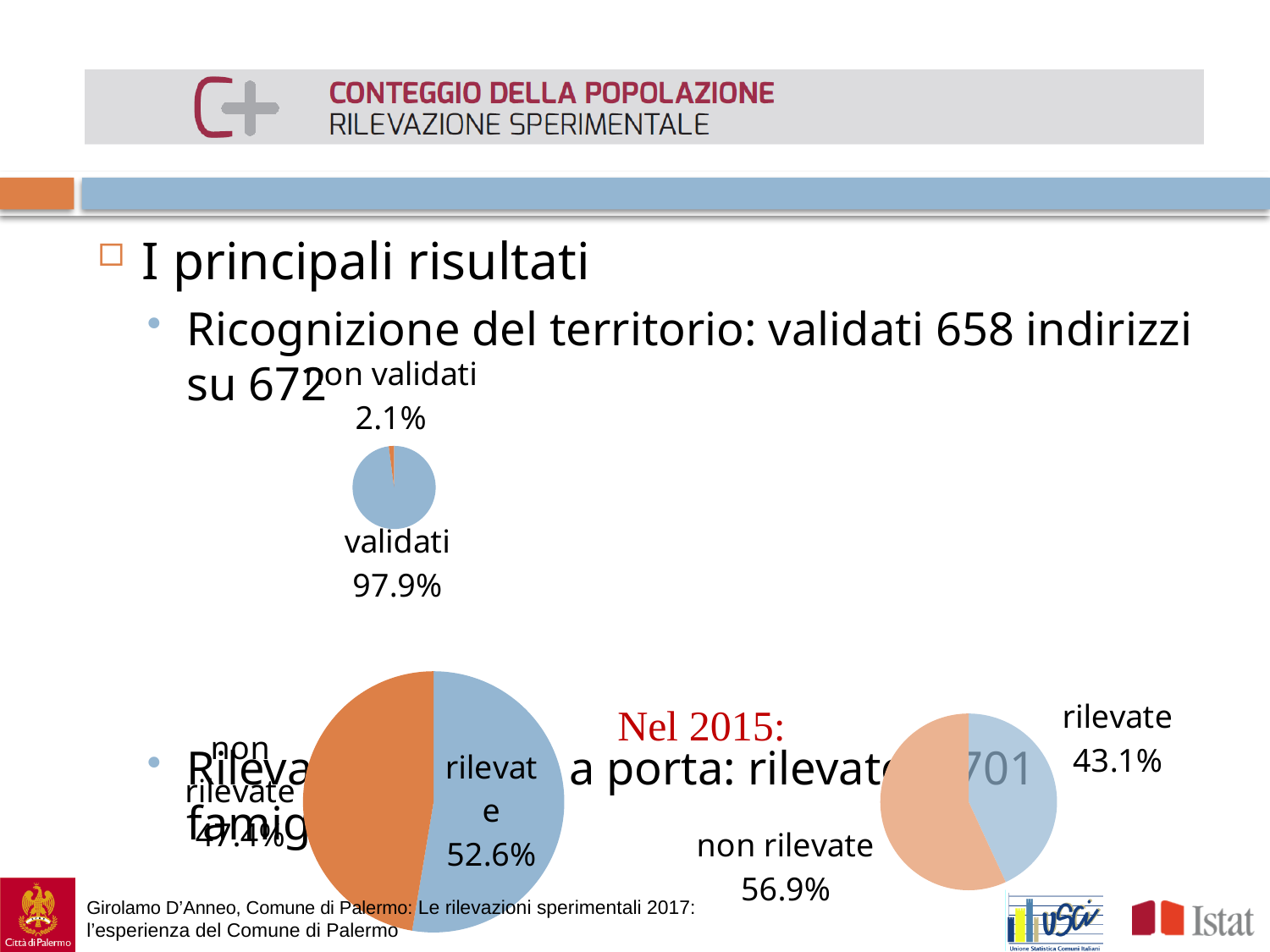
In the bottom-right pie chart (Nel 2015), what share is labelled 'rilevate'? 43.1% How many pie charts are shown on the slide? 3 In the bottom-left pie chart, what is the difference between the 'rilevate' and 'non rilevate' shares? 5.2% In the bottom-left pie chart, what share is labelled 'rilevate'? 52.6% In the top pie chart, what share is labelled 'non validati'? 2.1% What kind of chart is the top chart on the slide? pie chart In the top pie chart, which slice is the largest? validati In the bottom-left pie chart, what share is labelled 'non rilevate'? 47.4% In the top pie chart, what share is labelled 'validati'? 97.9% In the bottom-right pie chart (Nel 2015), which slice is larger, 'rilevate' or 'non rilevate'? non rilevate How many slices does the top pie chart have? 2 In the bottom-right pie chart (Nel 2015), what share is labelled 'non rilevate'? 56.9%